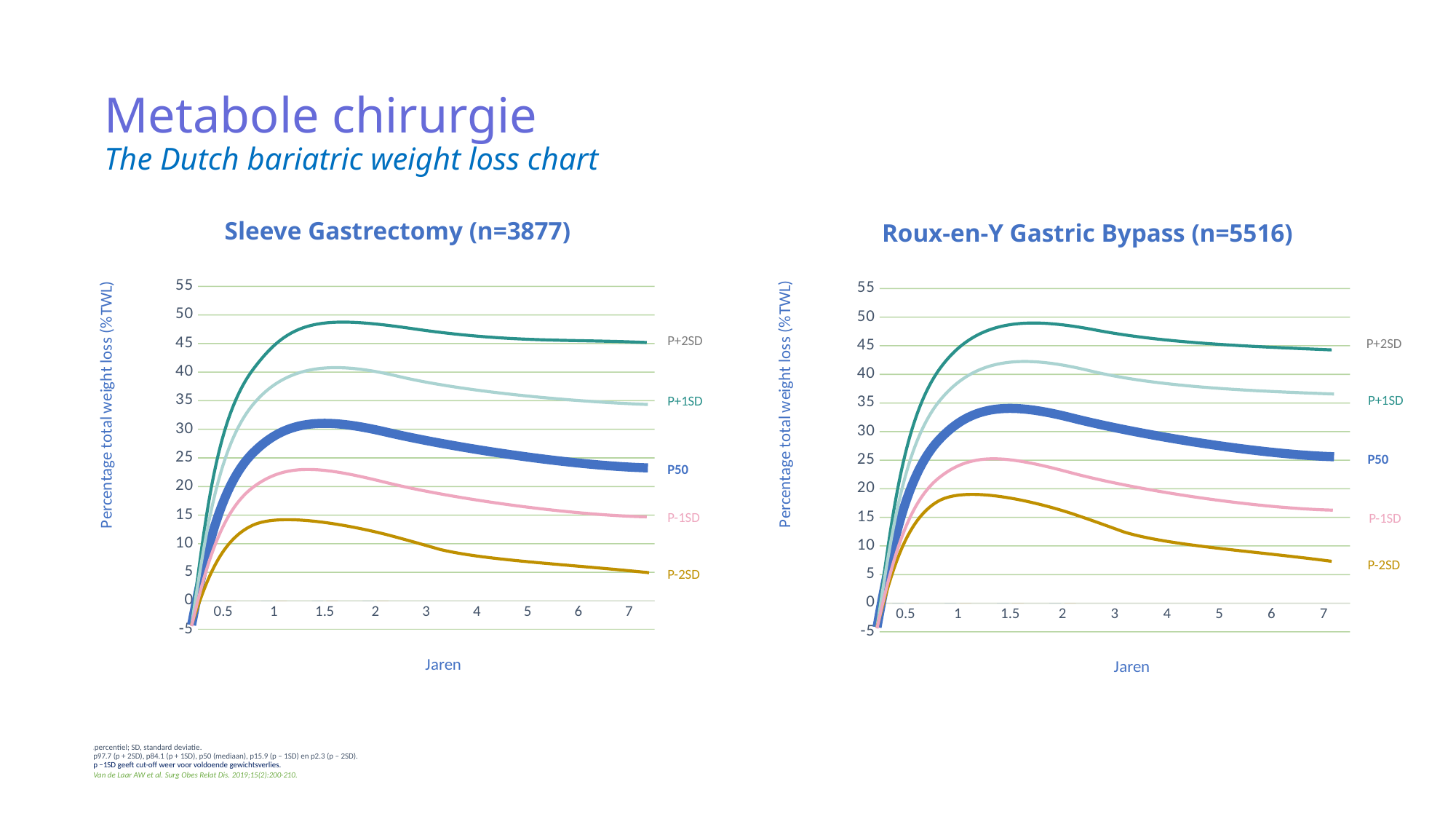
On the Roux-en-Y Gastric Bypass chart, is the P-2SD value at 7 years greater or less than 10? less How many percentile lines are plotted on the Roux-en-Y Gastric Bypass (n=5516) chart? 5 What is the label of the x axis on both charts? Jaren Which line is the highest on the Roux-en-Y Gastric Bypass chart? P+2SD On the Sleeve Gastrectomy chart, is the P-2SD value at 7 years greater or less than 10? less On the Sleeve Gastrectomy chart, is the P50 value at 7 years greater or less than 25? less On the Sleeve Gastrectomy chart, does the P50 line rise or fall between 2 and 7 years? fall Which line is the lowest on the Sleeve Gastrectomy chart? P-2SD Which chart shows a higher peak for the P-2SD line, Sleeve Gastrectomy or Roux-en-Y Gastric Bypass? Roux-en-Y Gastric Bypass What kind of chart is the Sleeve Gastrectomy (n=3877) chart? line chart